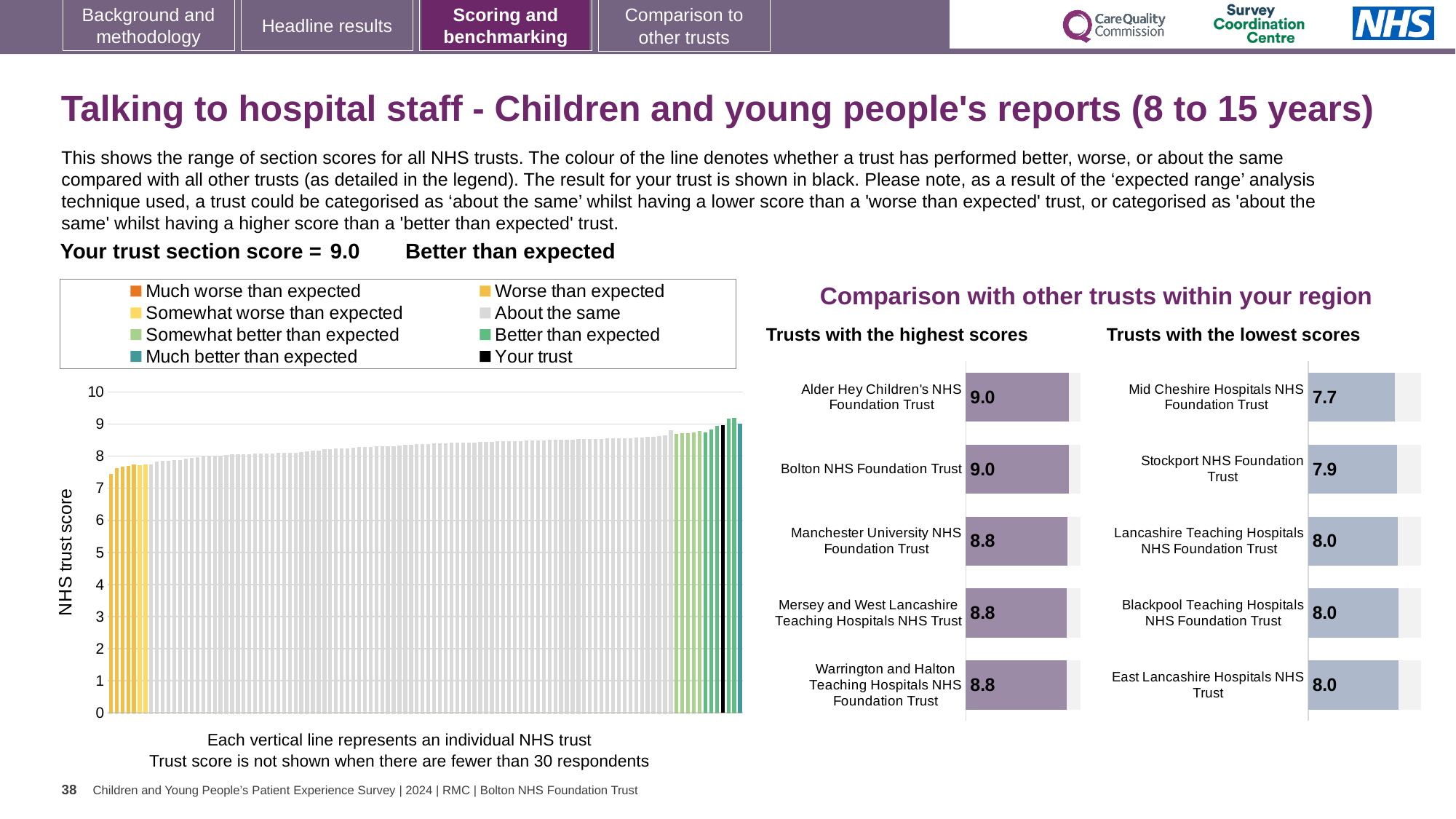
In the 'Trusts with the lowest scores' chart, which has the larger score: Stockport NHS Foundation Trust or Mid Cheshire Hospitals NHS Foundation Trust? Stockport NHS Foundation Trust In the 'Trusts with the lowest scores' chart, which trust has the lowest score? Mid Cheshire Hospitals NHS Foundation Trust In the 'Trusts with the highest scores' chart, what is the score for Manchester University NHS Foundation Trust? 8.8 In the large 'NHS trust score' chart on the left, do the bar values rise or fall from left to right? Rise In the 'Trusts with the lowest scores' chart, what is the score for Stockport NHS Foundation Trust? 7.9 How many entries does the legend above the large 'NHS trust score' chart list? 8 In the 'Trusts with the lowest scores' chart, what is the score for Mid Cheshire Hospitals NHS Foundation Trust? 7.7 What kind of chart is the large chart on the left with the y-axis labelled 'NHS trust score'? Bar chart In the 'Trusts with the highest scores' chart, what is the score for Alder Hey Children's NHS Foundation Trust? 9.0 How many trusts are shown in the 'Trusts with the highest scores' chart? 5 In the large 'NHS trust score' chart on the left, is the value of the leftmost (orange) bar greater or less than 8? less In the 'Trusts with the highest scores' chart, what is the difference between the scores of Alder Hey Children's NHS Foundation Trust and Warrington and Halton Teaching Hospitals NHS Foundation Trust? 0.2